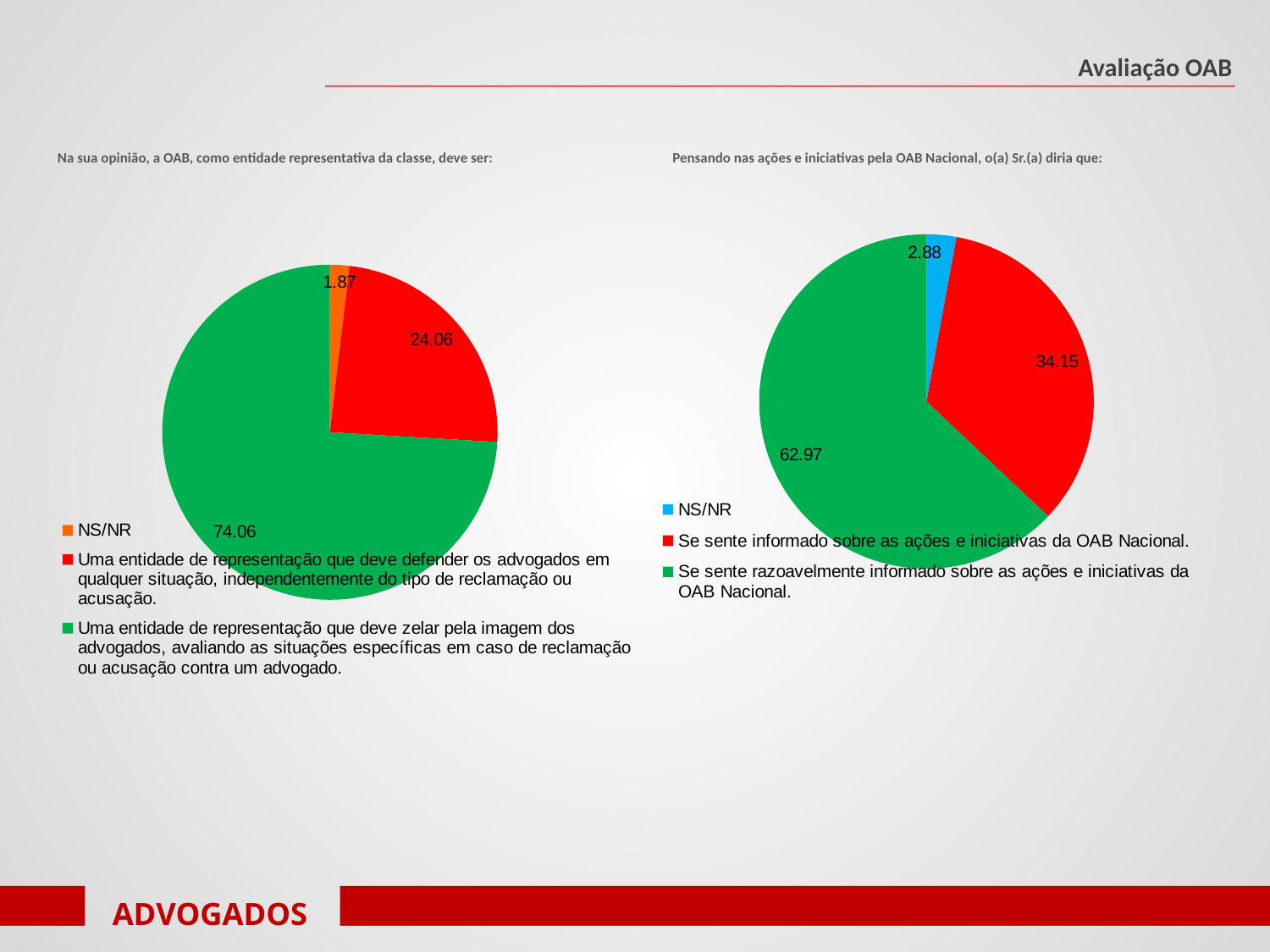
In the left pie chart, which category has the largest slice? Uma entidade de representação que deve zelar pela imagem dos advogados, avaliando as situações específicas em caso de reclamação ou acusação contra um advogado. In the left pie chart, what is the difference between the green slice (74.06) and the red slice (24.06)? 50 How many slices does the left pie chart have? 3 What type of chart is shown on the right side of the slide? Pie chart In the right pie chart, which is larger: the NS/NR slice or the 'Se sente informado' slice? Se sente informado sobre as ações e iniciativas da OAB Nacional. In the right pie chart, what is the value for NS/NR? 2.88 In the left pie chart, which category has the smallest slice? NS/NR In the right pie chart, what is the value for 'Se sente razoavelmente informado sobre as ações e iniciativas da OAB Nacional.'? 62.97 In the right pie chart, what is the value for 'Se sente informado sobre as ações e iniciativas da OAB Nacional.'? 34.15 In the right pie chart, what colour is the NS/NR slice? Blue In the left pie chart, what is the value for the slice 'Uma entidade de representação que deve defender os advogados em qualquer situação, independentemente do tipo de reclamação ou acusação.'? 24.06 In the left pie chart, what is the value for NS/NR? 1.87